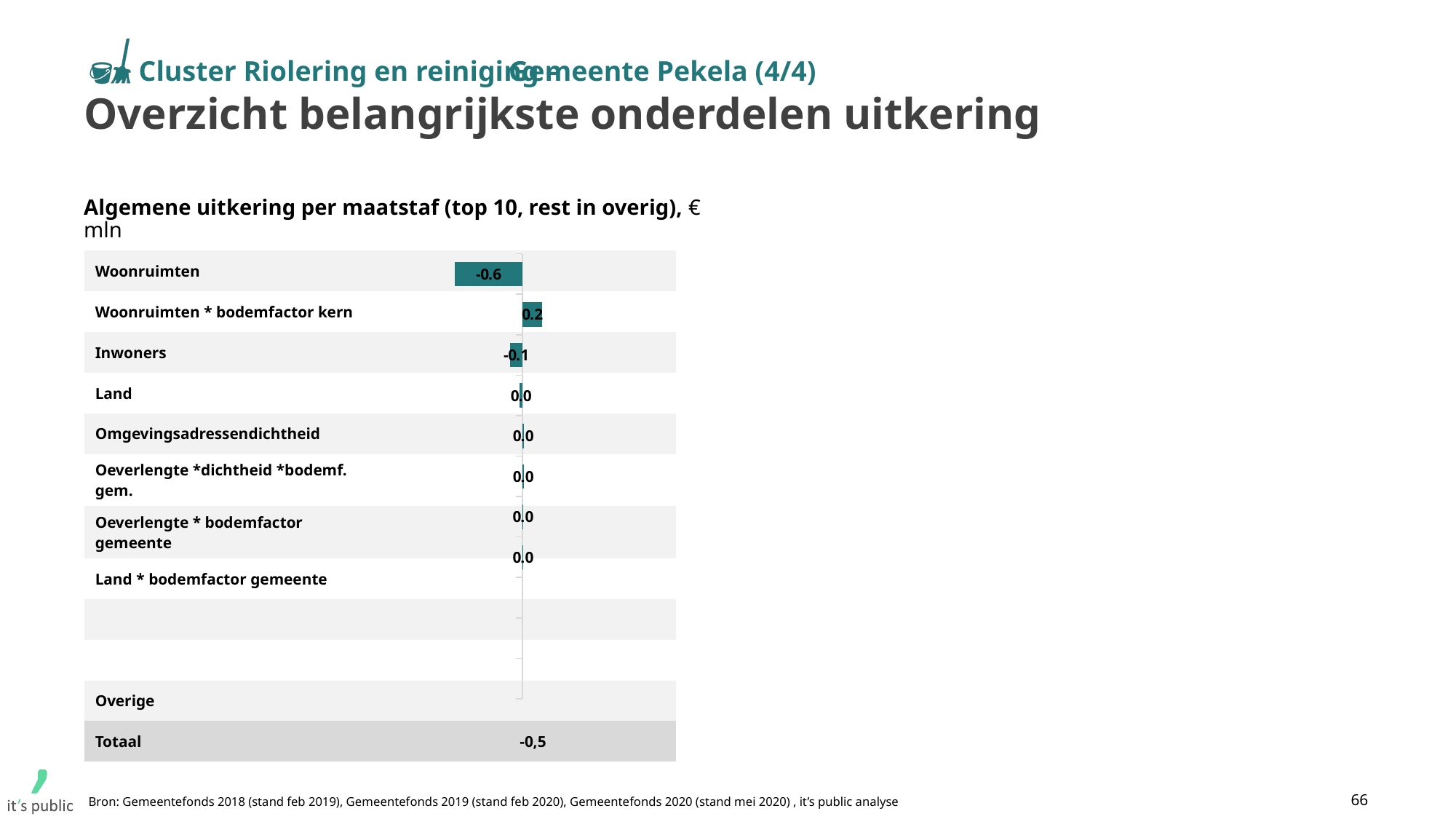
What is the value for Woonruimten? -0.6 What kind of chart is shown on the slide? bar chart What value is shown in the Totaal row below the chart? -0,5 What is the title of the chart? Algemene uitkering per maatstaf (top 10, rest in overig), € mln Which category has the lowest value? Woonruimten Which category has the highest value? Woonruimten * bodemfactor kern What is the difference between the values for Inwoners and Woonruimten? 0.5 What is the value for Inwoners? -0.1 What is the difference between the values for Woonruimten * bodemfactor kern and Inwoners? 0.3 Which is larger, the value for Woonruimten * bodemfactor kern or the value for Woonruimten? Woonruimten * bodemfactor kern What is the value for Land? 0.0 What is the value for Woonruimten * bodemfactor kern? 0.2